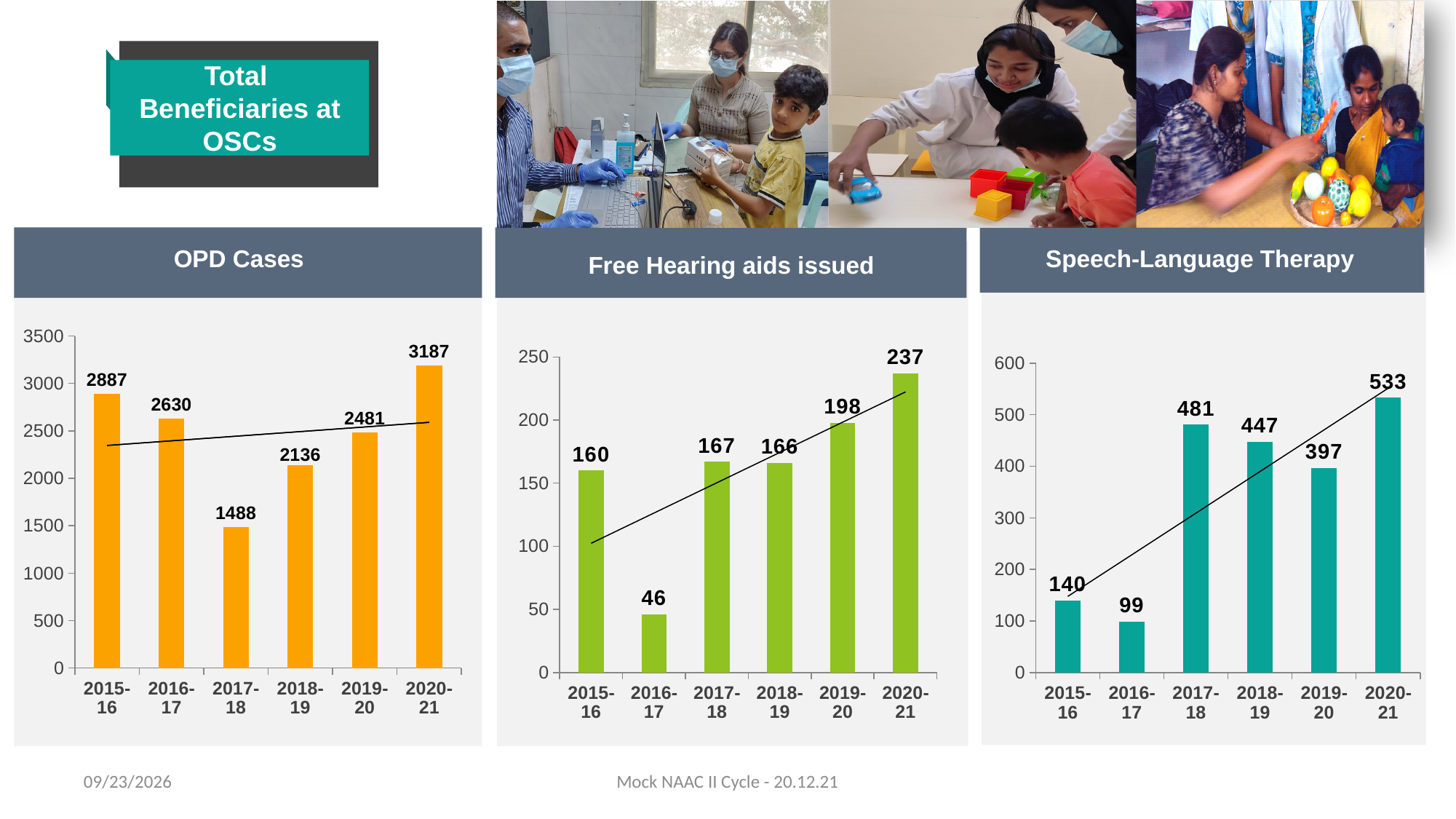
In the Free Hearing aids issued chart, which is larger, the value for 2019-20 or the value for 2015-16? 2019-20 What colour are the bars in the OPD Cases chart? Orange In the OPD Cases chart, which year has the highest value? 2020-21 In the Speech-Language Therapy chart, which year has the highest value? 2020-21 In the OPD Cases chart, what is the difference between the values for 2020-21 and 2015-16? 300 What kind of chart is the Free Hearing aids issued chart? Bar chart In the Speech-Language Therapy chart, what is the difference between the values for 2017-18 and 2016-17? 382 In the Speech-Language Therapy chart, what is the value for 2018-19? 447 In the Free Hearing aids issued chart, which year has the lowest value? 2016-17 How many years are shown on the x axis of the Speech-Language Therapy chart? 6 In the OPD Cases chart, what is the value for 2017-18? 1488 In the Free Hearing aids issued chart, what is the value for 2016-17? 46